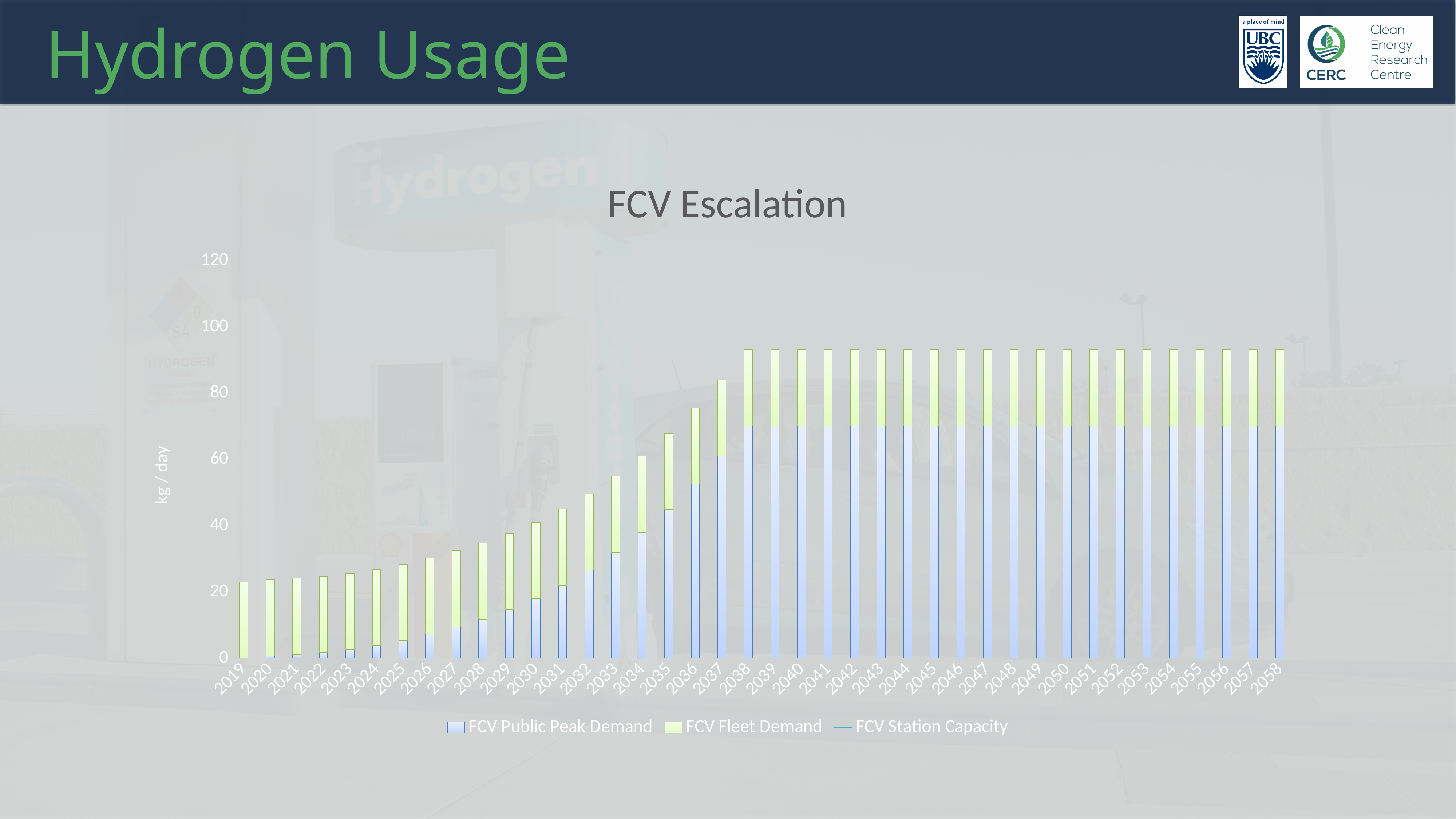
Is the total stacked bar for 2019 greater or less than 20? greater What is the title of the chart? FCV Escalation Is the FCV Public Peak Demand value for 2058 greater or less than 60? greater At what value does the FCV Station Capacity line sit? 100 How many series does the legend list? 3 What is the label on the vertical axis? kg / day Is the total stacked bar for 2058 greater or less than 100? less What type of chart is shown on the slide? Stacked bar chart with a line (combination chart) How many years are shown along the x axis? 40 Which is larger, the total stacked bar for 2025 or the total stacked bar for 2035? 2035 Do the total stacked bar heights rise or fall from 2019 to 2038? rise